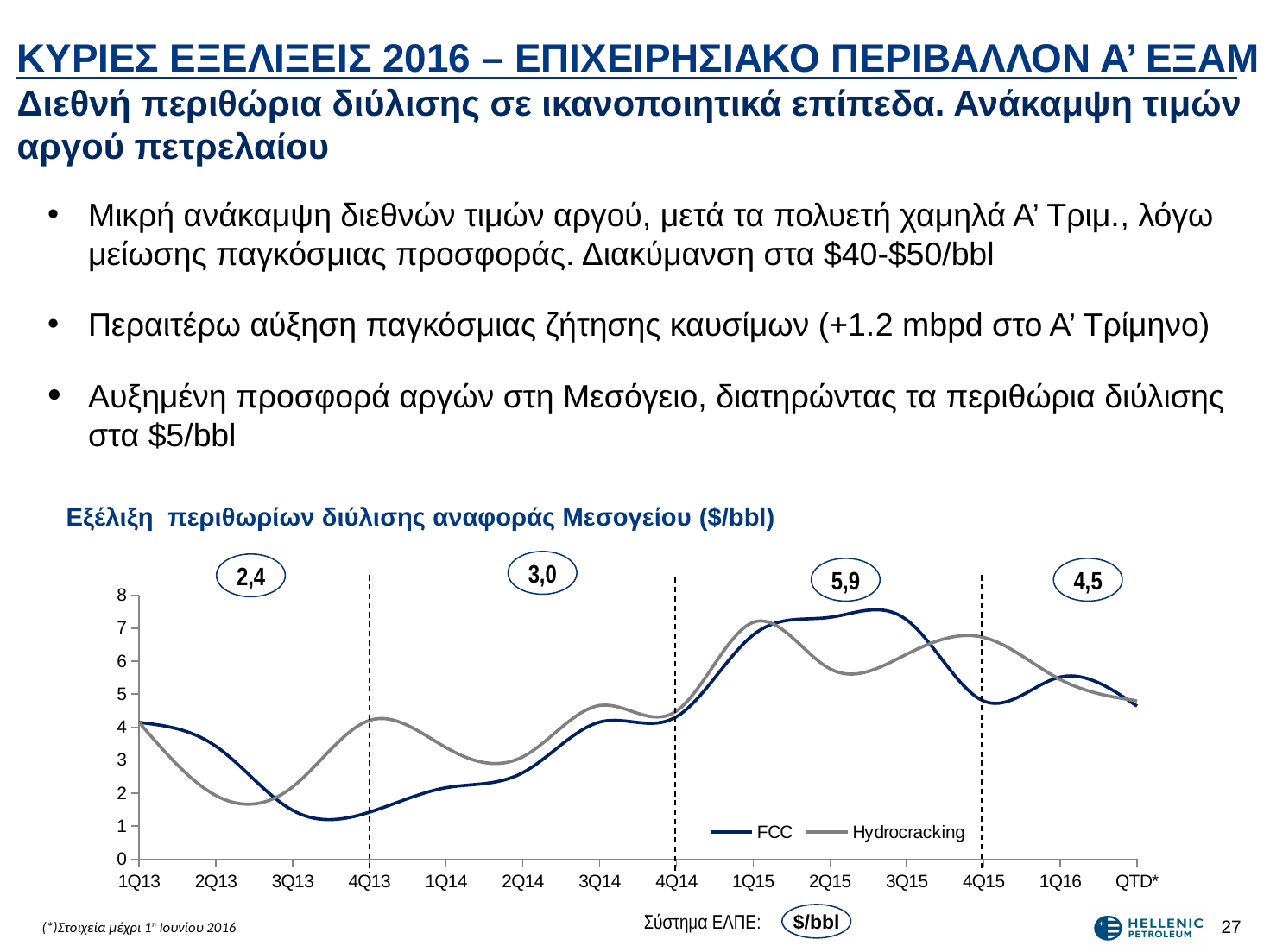
What are the two series named in the chart legend? FCC and Hydrocracking How many series does the chart legend list? 2 How many quarterly points are shown along the x axis of the chart? 14 Is the FCC value at 3Q15 greater or less than 7? greater What kind of chart is shown on the slide? line chart Does the FCC series rise or fall between 4Q13 and 3Q15? rise At 4Q13, which series has the higher value, FCC or Hydrocracking? Hydrocracking Is the Hydrocracking value at 4Q15 greater or less than 6? greater Is the FCC value at 4Q13 greater or less than 2? less At 3Q15, which series has the higher value, FCC or Hydrocracking? FCC